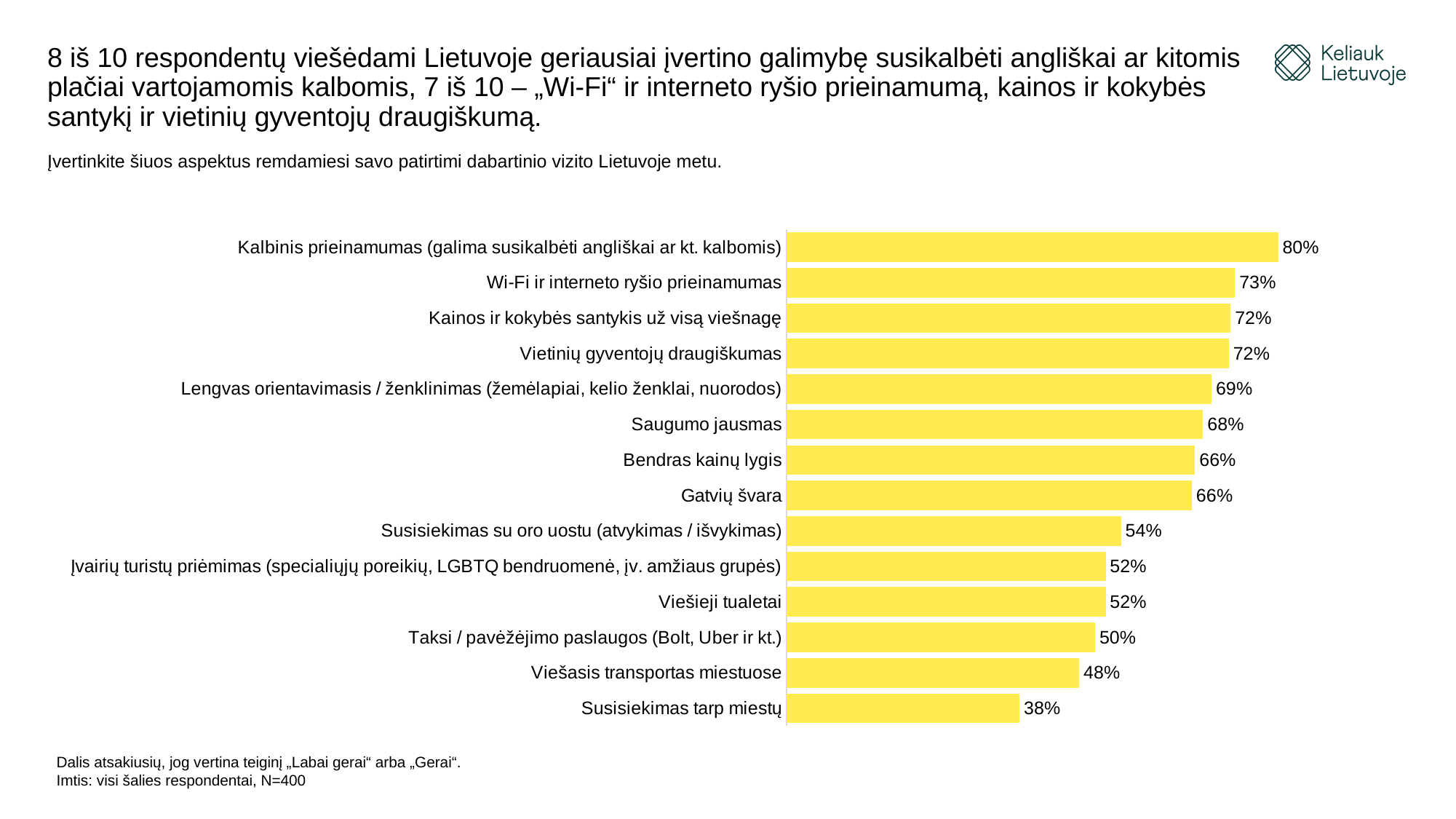
What is the difference between the values for "Kalbinis prieinamumas (galima susikalbėti angliškai ar kt. kalbomis)" and "Susisiekimas tarp miestų"? 42% What is the difference between the values for "Susisiekimas su oro uostu (atvykimas / išvykimas)" and "Taksi / pavėžėjimo paslaugos (Bolt, Uber ir kt.)"? 4% What is the value for "Saugumo jausmas"? 68% What is the sample size (N) stated below the chart? N=400 What is the value for "Viešasis transportas miestuose"? 48% Which is larger: the value for "Gatvių švara" or the value for "Viešieji tualetai"? Gatvių švara What is the value for "Wi-Fi ir interneto ryšio prieinamumas"? 73% What colour are the bars in the chart? Yellow Which category has the lowest value? Susisiekimas tarp miestų Which category has the highest value? Kalbinis prieinamumas (galima susikalbėti angliškai ar kt. kalbomis) How many categories are shown in the chart? 14 What kind of chart is shown on the slide? Bar chart